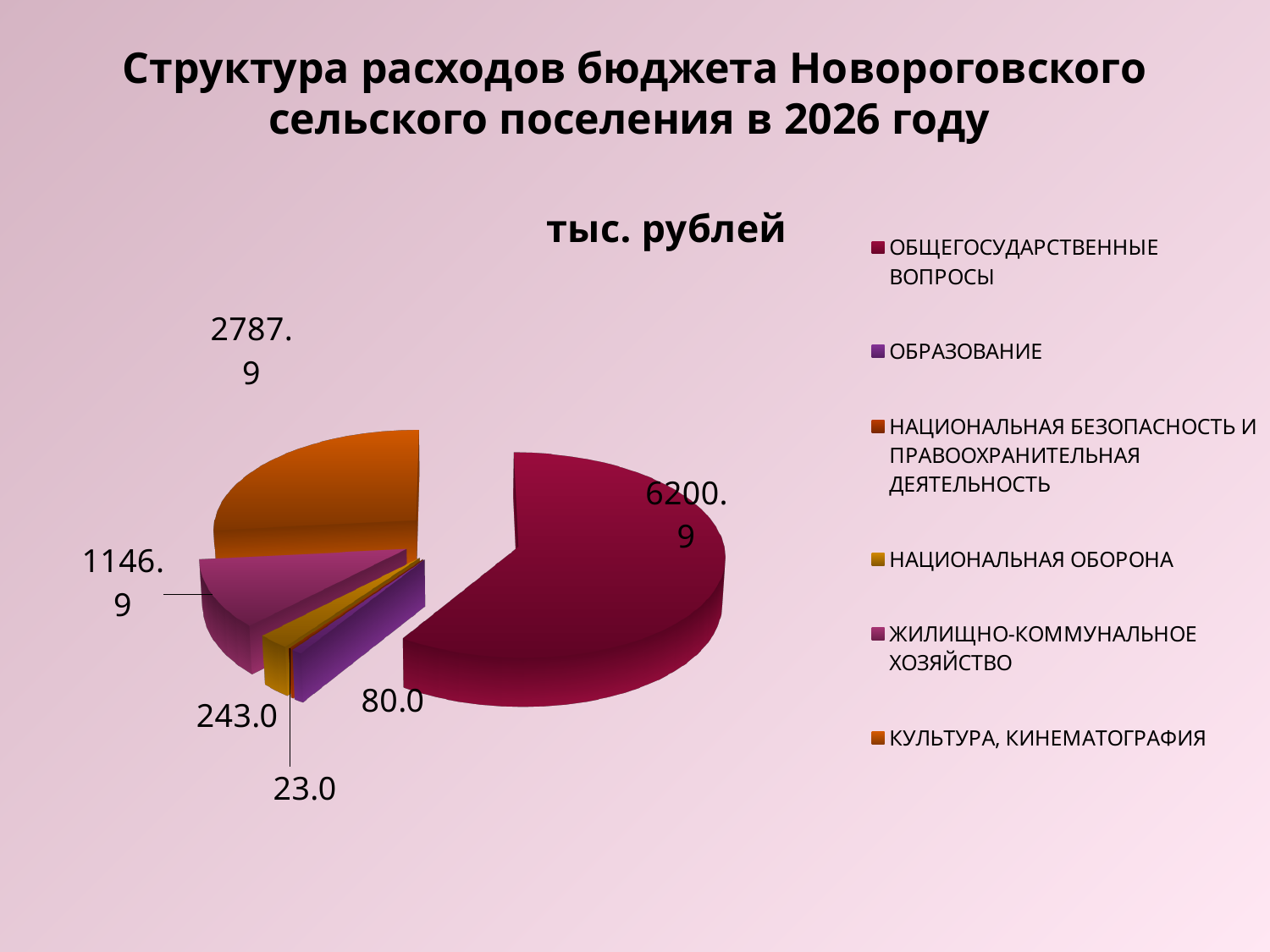
What is the value for КУЛЬТУРА, КИНЕМАТОГРАФИЯ? 2787.9 Which is larger, the value for НАЦИОНАЛЬНАЯ ОБОРОНА or the value for ОБРАЗОВАНИЕ? НАЦИОНАЛЬНАЯ ОБОРОНА What is the value for ОБРАЗОВАНИЕ? 80.0 How many categories does the legend list? 6 Which category has the largest slice of the pie? ОБЩЕГОСУДАРСТВЕННЫЕ ВОПРОСЫ What is the title shown above the pie chart? тыс. рублей What is the value for НАЦИОНАЛЬНАЯ ОБОРОНА? 243.0 What is the difference between the values for КУЛЬТУРА, КИНЕМАТОГРАФИЯ and ЖИЛИЩНО-КОММУНАЛЬНОЕ ХОЗЯЙСТВО? 1641.0 What is the value for ЖИЛИЩНО-КОММУНАЛЬНОЕ ХОЗЯЙСТВО? 1146.9 What type of chart is shown on the slide? pie chart What is the value for ОБЩЕГОСУДАРСТВЕННЫЕ ВОПРОСЫ? 6200.9 Which category has the smallest slice of the pie? НАЦИОНАЛЬНАЯ БЕЗОПАСНОСТЬ И ПРАВООХРАНИТЕЛЬНАЯ ДЕЯТЕЛЬНОСТЬ